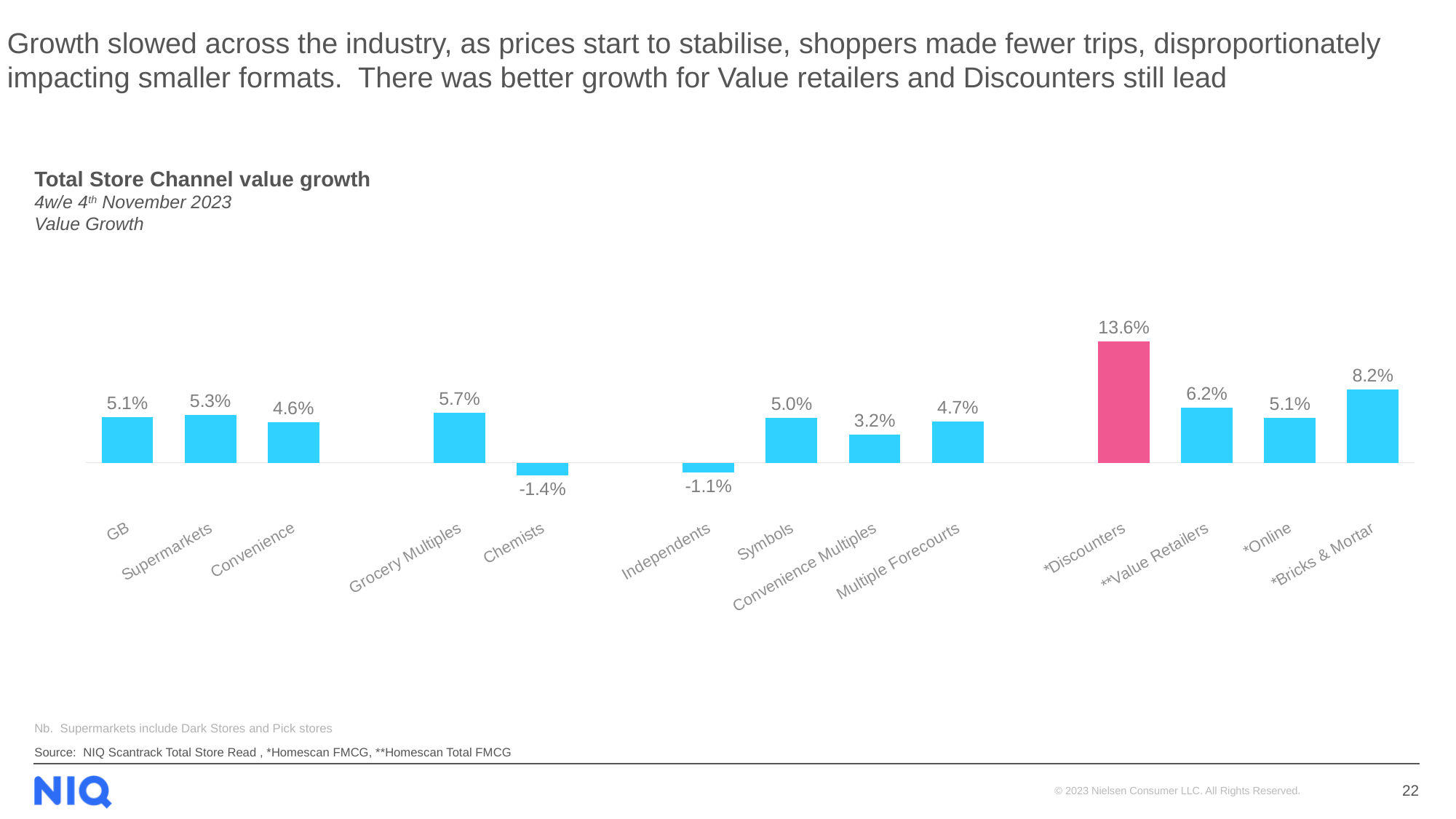
What is the value growth for Supermarkets? 5.3% What is the title of the chart? Total Store Channel value growth What is the value growth for *Discounters? 13.6% How many channels are shown on the chart? 14 What type of chart is shown on the slide? Bar chart Which channel has the lowest value growth? Chemists Which bar is highlighted in a different colour (pink) from the others? *Discounters What is the value growth for Convenience Multiples? 3.2% Which channel has the highest value growth? *Discounters Which has higher value growth, Grocery Multiples or Convenience? Grocery Multiples What is the value growth for Chemists? -1.4% What is the difference in value growth between *Discounters and **Value Retailers? 7.4%